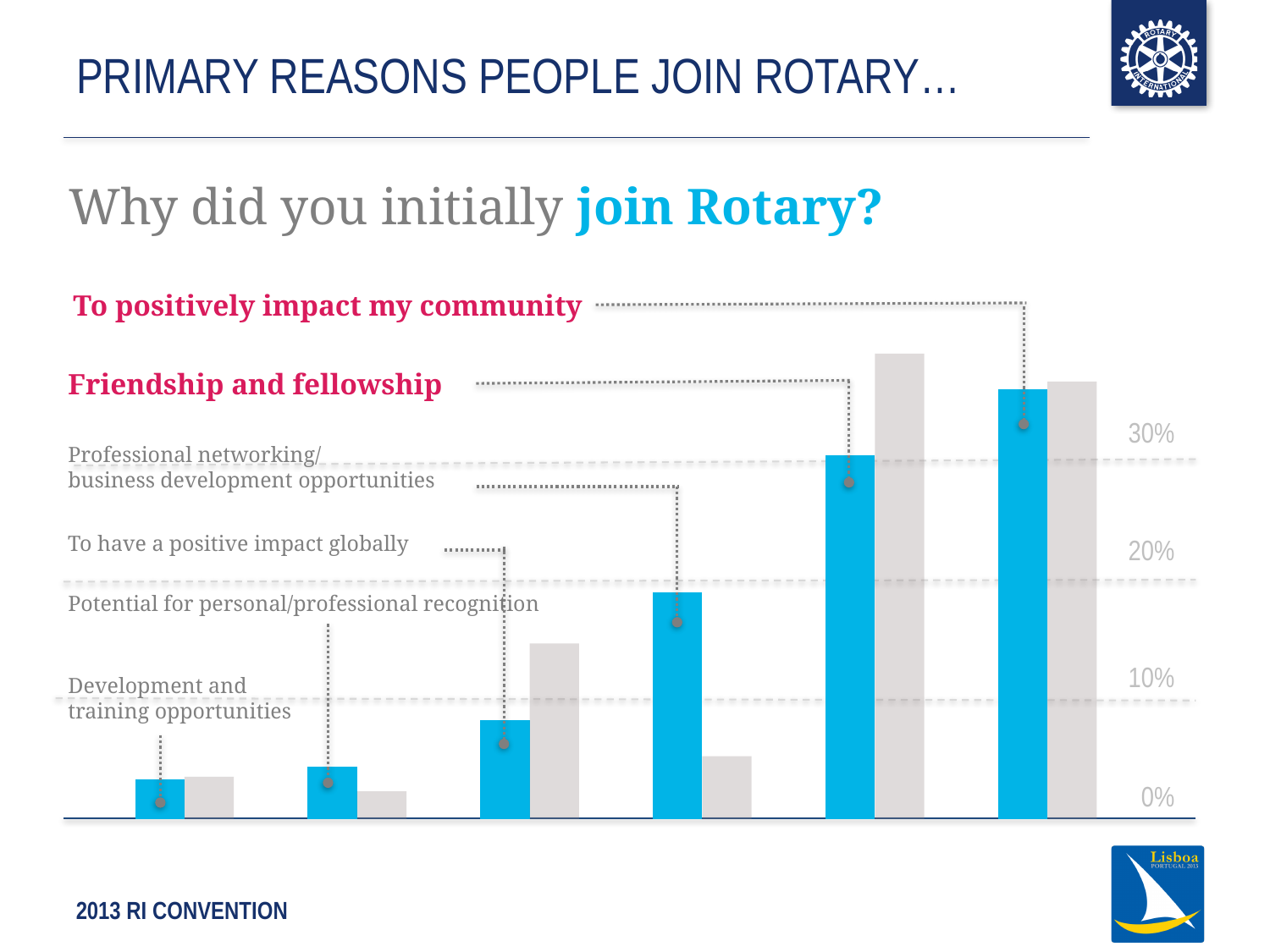
What kind of chart is shown on the slide? bar chart Is the blue bar for To have a positive impact globally greater or less than 10%? less Is the blue bar for Friendship and fellowship greater or less than 20%? greater Which reason has the tallest grey bar? Friendship and fellowship How many reasons (categories) are plotted on the chart? 6 Is the grey bar for Friendship and fellowship greater or less than 30%? greater For Professional networking/business development opportunities, which bar is taller, the blue one or the grey one? the blue one Do the blue bars generally rise or fall from left to right across the chart? rise Which reason has the tallest blue bar? To positively impact my community For To have a positive impact globally, which bar is taller, the blue one or the grey one? the grey one